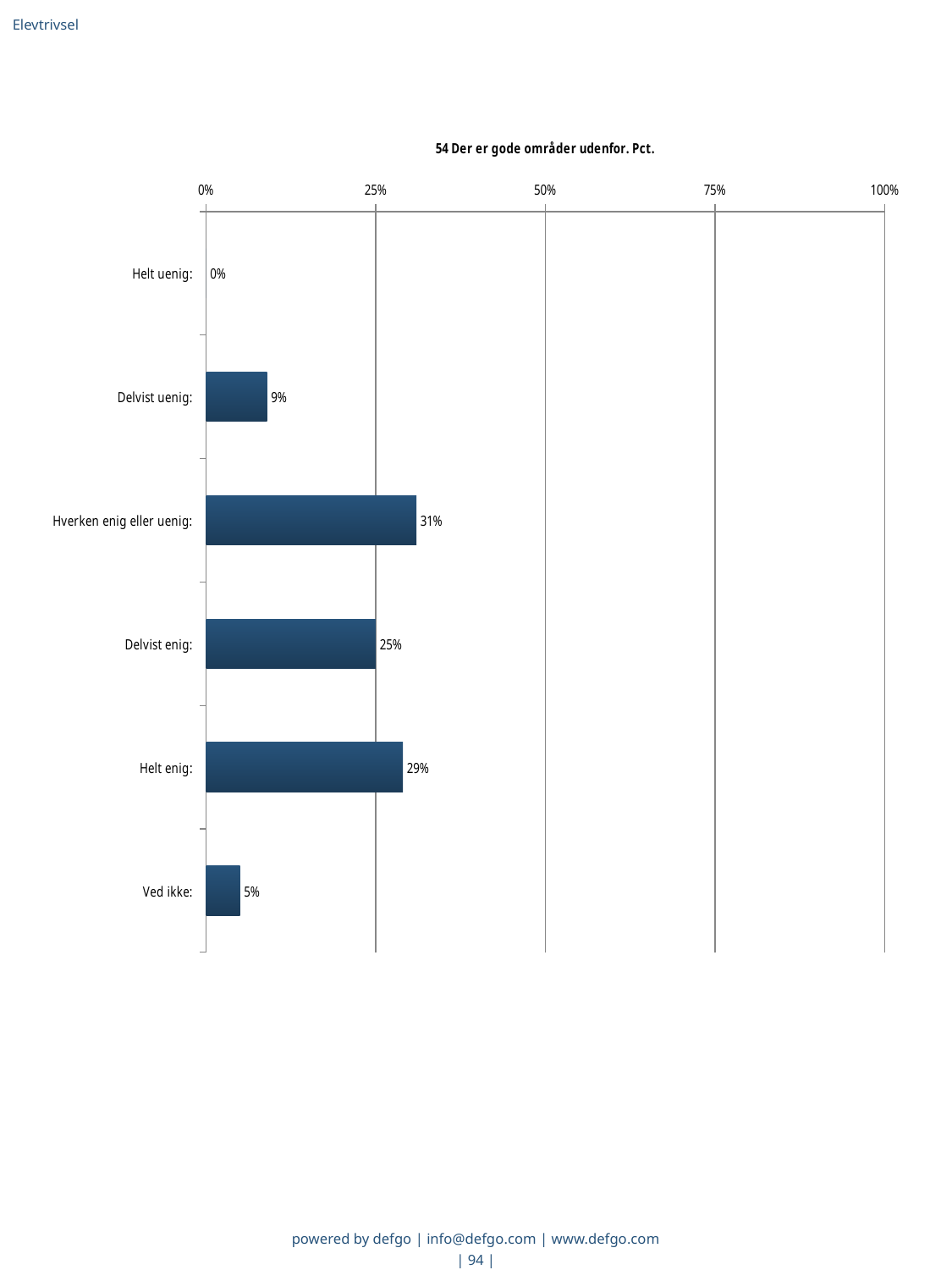
What kind of chart is shown on the slide? bar chart What is the value for "Helt enig"? 29% What is the title of the chart? 54 Der er gode områder udenfor. Pct. Which category has the lowest value? Helt uenig What is the value for "Hverken enig eller uenig"? 31% Which category has the highest value? Hverken enig eller uenig What is the difference between the values for "Helt enig" and "Delvist enig"? 4% Is the value for "Hverken enig eller uenig" greater or less than 25%? greater What is the value for "Delvist uenig"? 9% Which is larger, the value for "Delvist uenig" or the value for "Ved ikke"? Delvist uenig What is the value for "Ved ikke"? 5% How many categories are shown in the chart? 6